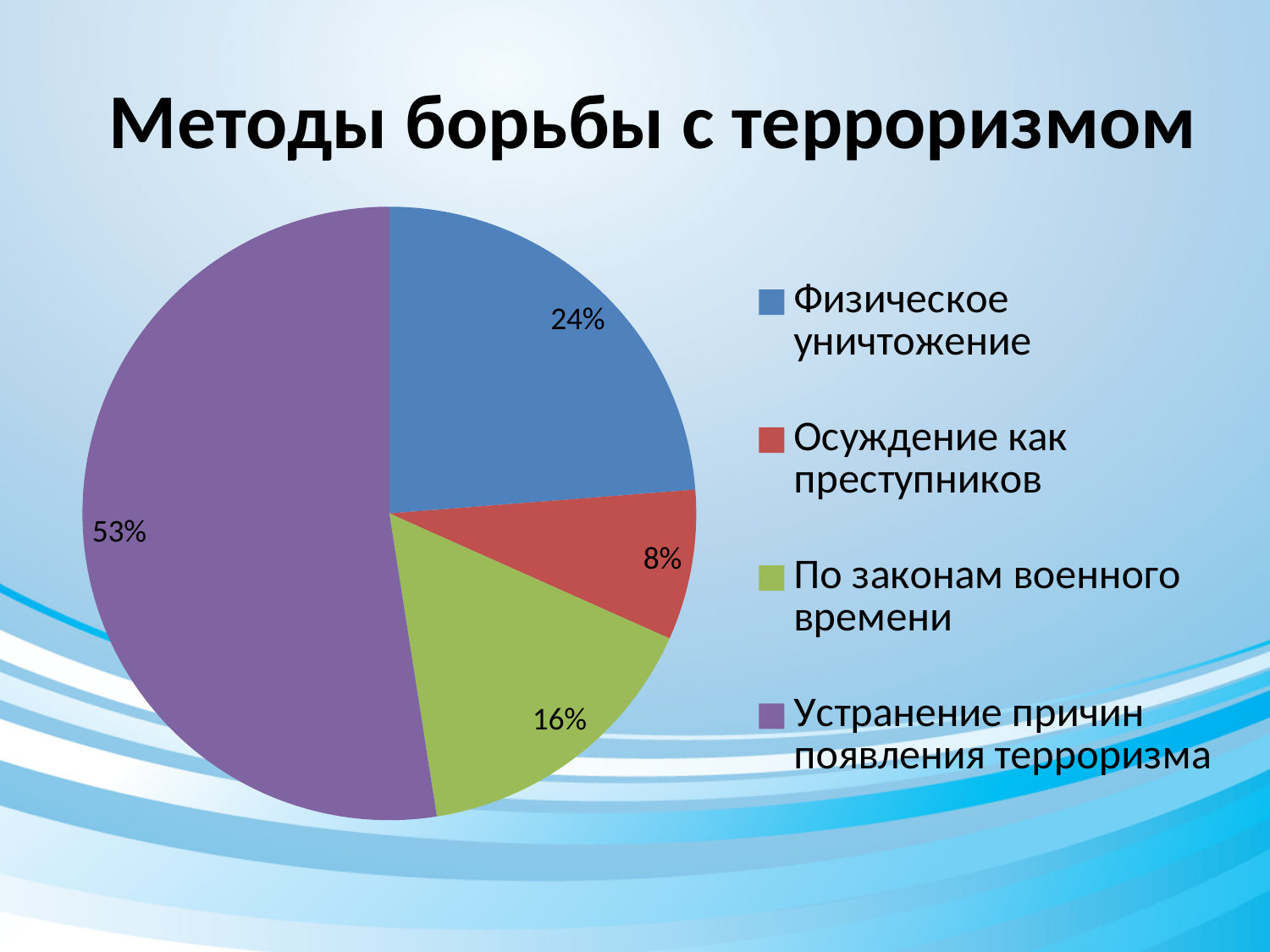
What share of the pie is labelled for "Осуждение как преступников"? 8% What share of the pie is labelled for "Устранение причин появления терроризма"? 53% Which category has the smallest slice of the pie? Осуждение как преступников Which category has the largest slice of the pie? Устранение причин появления терроризма Which is larger: the slice for "По законам военного времени" or the slice for "Осуждение как преступников"? По законам военного времени What share of the pie is labelled for "По законам военного времени"? 16% What share of the pie is labelled for "Физическое уничтожение"? 24% How many slices does the pie chart have? 4 What is the difference in percentage points between "Устранение причин появления терроризма" and "Физическое уничтожение"? 29 What is the title of the slide? Методы борьбы с терроризмом What kind of chart is shown on the slide? pie chart How many entries does the legend list? 4